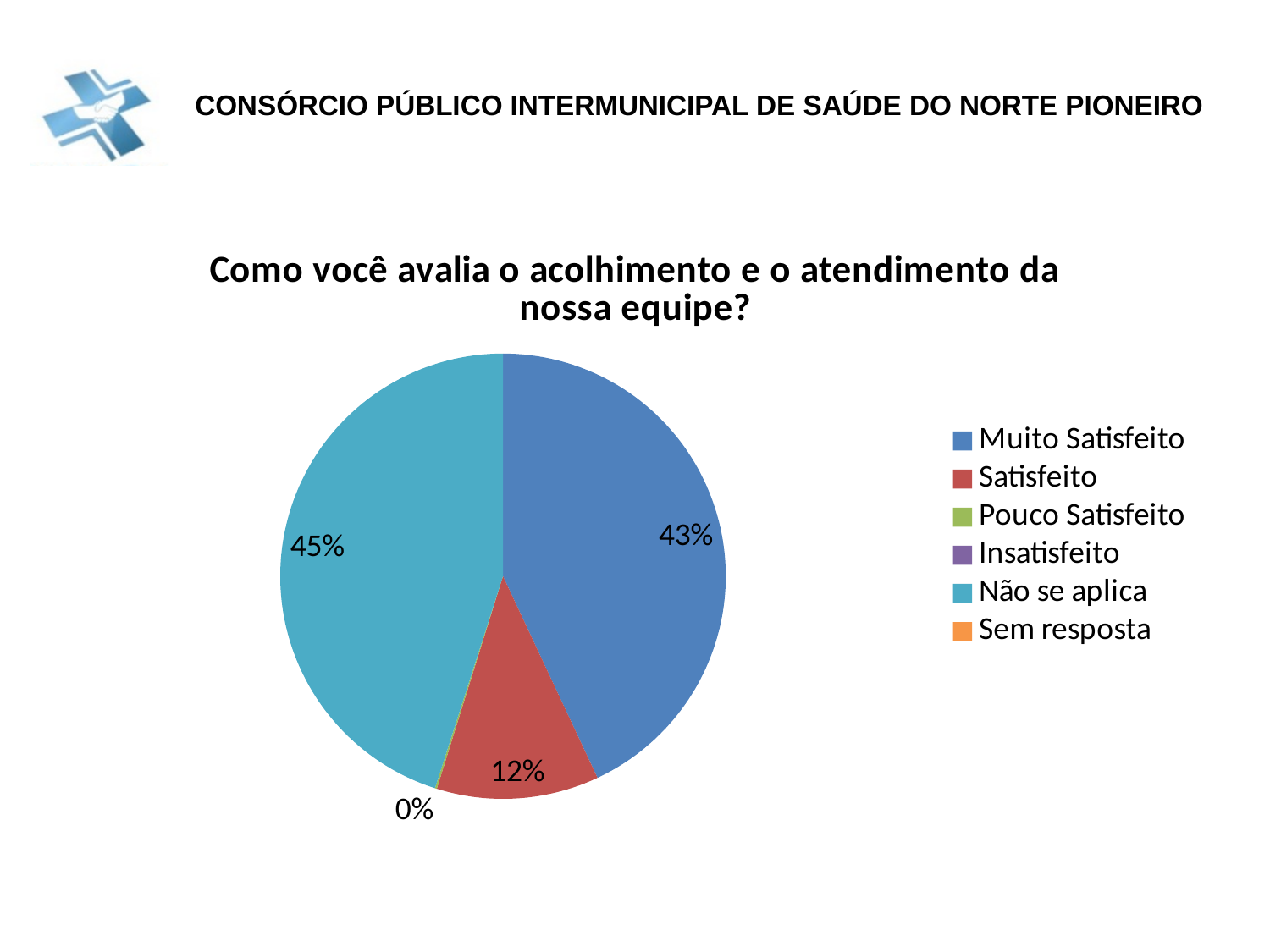
How many categories does the legend list? 6 What is the title of the chart? Como você avalia o acolhimento e o atendimento da nossa equipe? Which category has the largest slice of the pie? Não se aplica What is the difference in percentage points between the Não se aplica slice and the Muito Satisfeito slice? 2 percentage points What percentage of the pie is labelled for Muito Satisfeito? 43% What kind of chart is shown on the slide? Pie chart What percentage of the pie is labelled for Satisfeito? 12% What is the combined share of the Muito Satisfeito and Satisfeito slices? 55% Which slice is larger, Muito Satisfeito or Satisfeito? Muito Satisfeito Which slice is larger, Não se aplica or Muito Satisfeito? Não se aplica What percentage of the pie is labelled for Não se aplica? 45% What is the difference in percentage points between the Muito Satisfeito slice and the Satisfeito slice? 31 percentage points